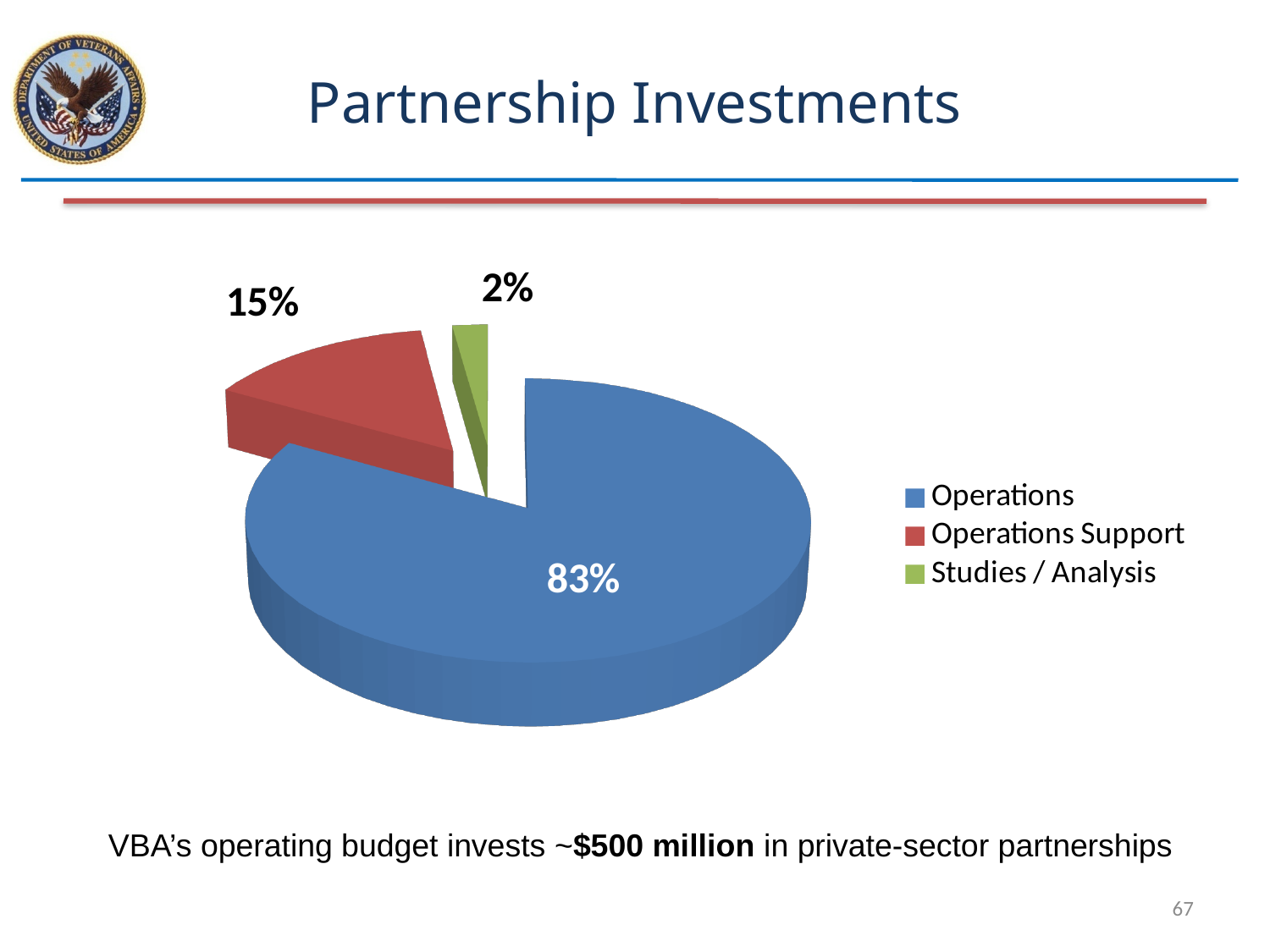
How many categories are shown in the pie chart? 3 Which is larger, the share for Operations Support or the share for Studies / Analysis? Operations Support What share of the pie does Operations represent? 83% What is the title of the slide containing the chart? Partnership Investments What kind of chart is shown on the slide? Pie chart What is the difference in percentage points between Operations Support and Studies / Analysis? 13 What colour is the Operations Support slice in the pie chart? Red What share of the pie does Operations Support represent? 15% Which category has the largest slice of the pie? Operations Which category has the smallest slice of the pie? Studies / Analysis What is the difference in percentage points between Operations and Operations Support? 68 What share of the pie does Studies / Analysis represent? 2%